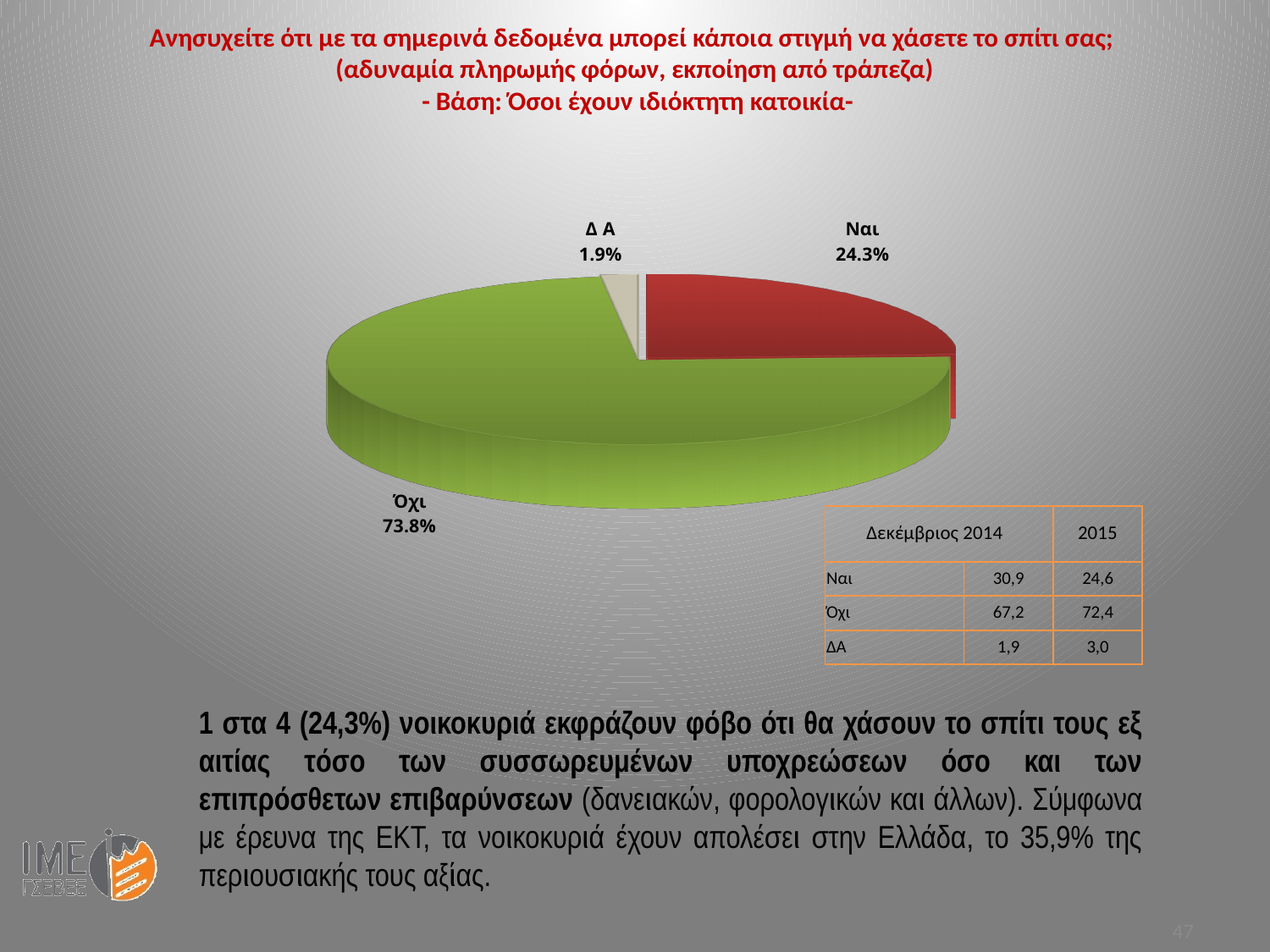
What percentage of the pie chart is the "Δ Α" slice? 1.9% What colour is the "Όχι" slice of the pie chart? green Which slice of the pie chart is the largest? Όχι What is the difference in percentage points between the "Ναι" and "Δ Α" slices of the pie chart? 22.4 What percentage of the pie chart is the "Όχι" slice? 73.8% How many slices does the pie chart have? 3 What percentage of the pie chart is the "Ναι" slice? 24.3% Which slice of the pie chart is the smallest? Δ Α What is the difference in percentage points between the "Όχι" and "Ναι" slices of the pie chart? 49.5 What kind of chart is shown on the slide? pie chart Which is larger in the pie chart, the "Ναι" slice or the "Δ Α" slice? Ναι What colour is the "Ναι" slice of the pie chart? red